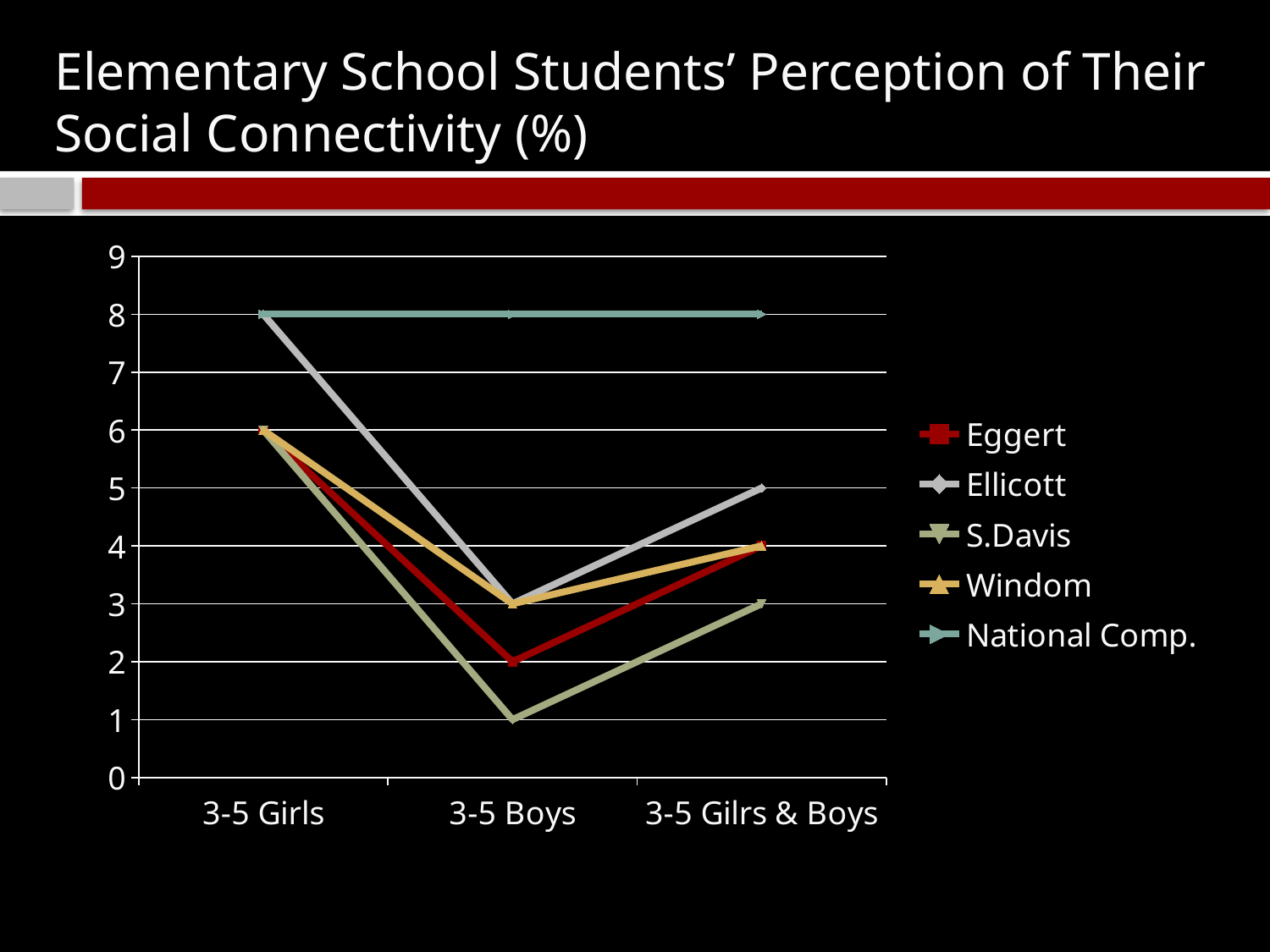
Which is larger at 3-5 Boys, Windom or Eggert? Windom What is the value for Eggert at 3-5 Boys? 2 What type of chart is shown on the slide? line chart How many series does the legend list? 5 Which series has the highest value at 3-5 Gilrs & Boys? National Comp. Does the National Comp. line rise, fall, or stay flat across the x axis? stays flat What is the value for S.Davis at 3-5 Boys? 1 What is the value for National Comp. at 3-5 Gilrs & Boys? 8 What is the value for Ellicott at 3-5 Girls? 8 What is the difference between Ellicott and Eggert at 3-5 Gilrs & Boys? 1 Which series has the lowest value at 3-5 Boys? S.Davis How many categories are shown on the x axis? 3